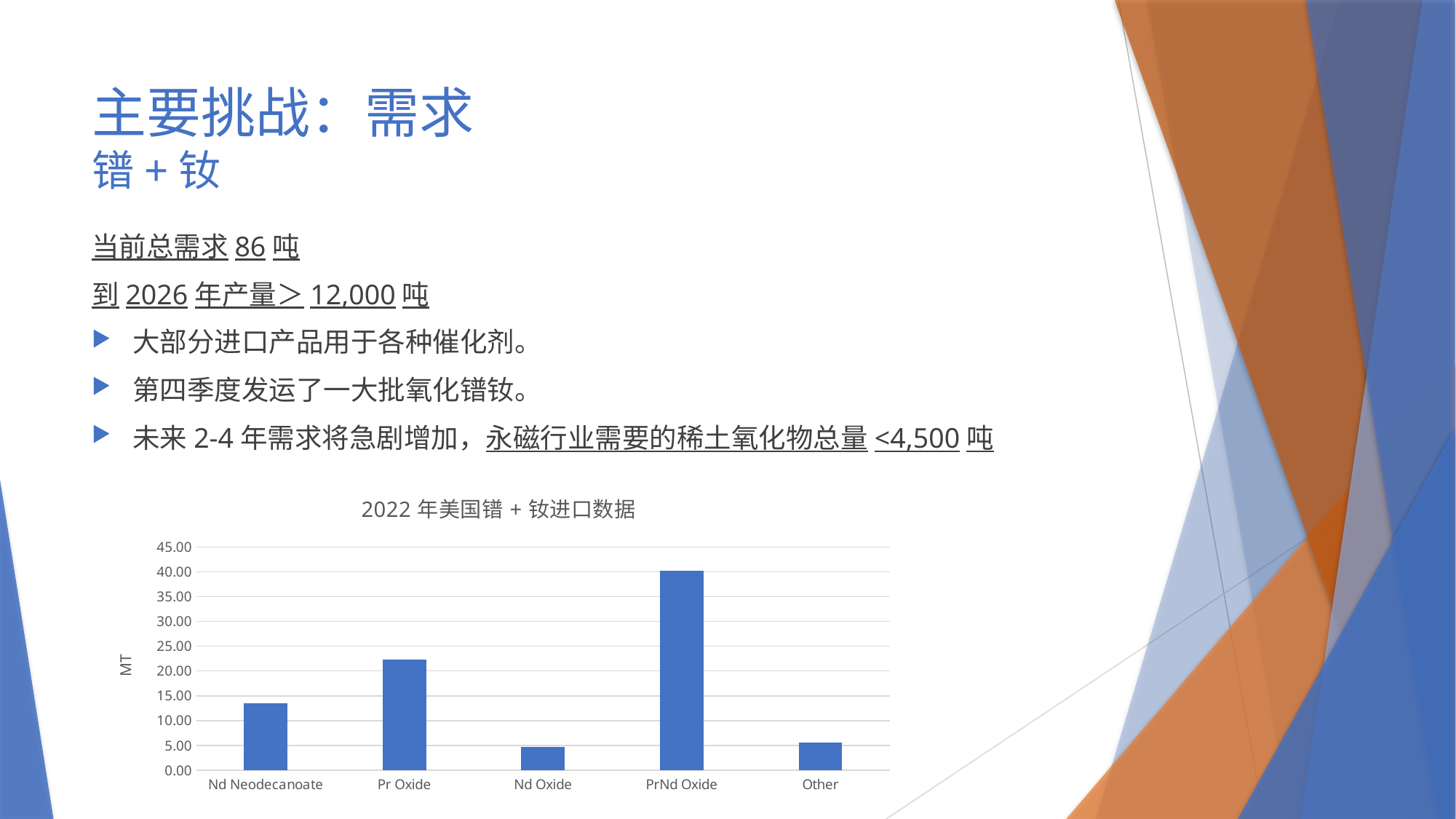
Is the value for Nd Neodecanoate greater or less than 10.00? greater Is the value for Other greater or less than 10.00? less What kind of chart is shown on the slide? bar chart Is the value for PrNd Oxide greater or less than 35.00? greater Which is larger, the value for PrNd Oxide or the value for Pr Oxide? PrNd Oxide Which is larger, the value for Pr Oxide or the value for Nd Neodecanoate? Pr Oxide What is the label on the y axis of the chart? MT How many categories are shown on the x axis of the chart? 5 What is the title of the chart? 2022 年美国镨 + 钕进口数据 Which category has the highest value in the chart? PrNd Oxide